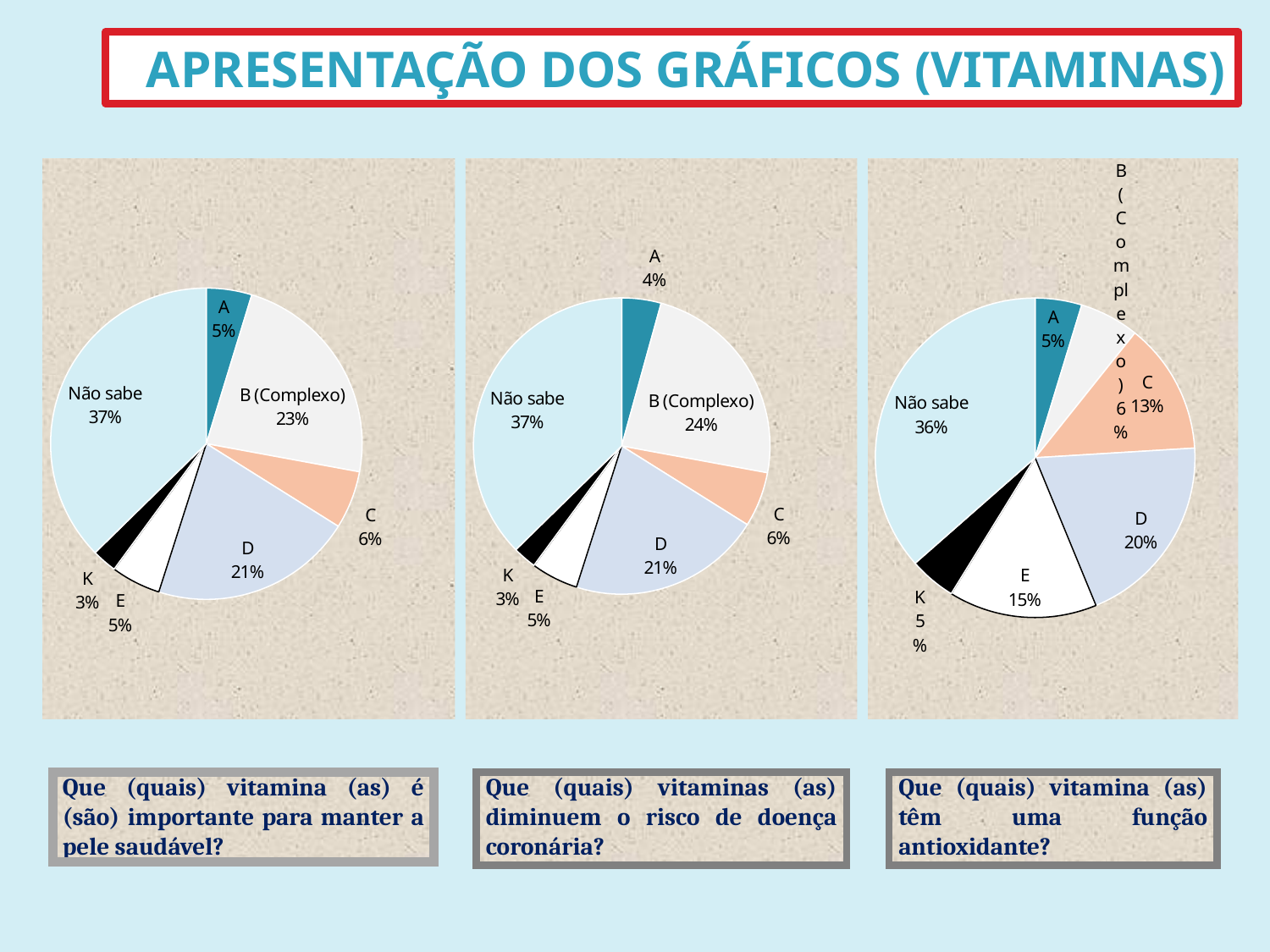
In the right pie chart, what is the value for K? 5% What type of chart is shown in the middle panel? Pie chart In the left pie chart, what share is labelled 'Não sabe'? 37% In the middle pie chart, what is the value for A? 4% How many pie charts are shown on the slide? 3 In the right pie chart, which category has the largest slice? Não sabe In the right pie chart, which is larger, the slice for C or the slice for D? D In the left pie chart, what is the value for B (Complexo)? 23% In the left pie chart, which category has the smallest slice? K In the right pie chart, what is the value for E? 15% How many slices does the left pie chart have? 7 In the middle pie chart, what is the difference between the values for B (Complexo) and D? 3%